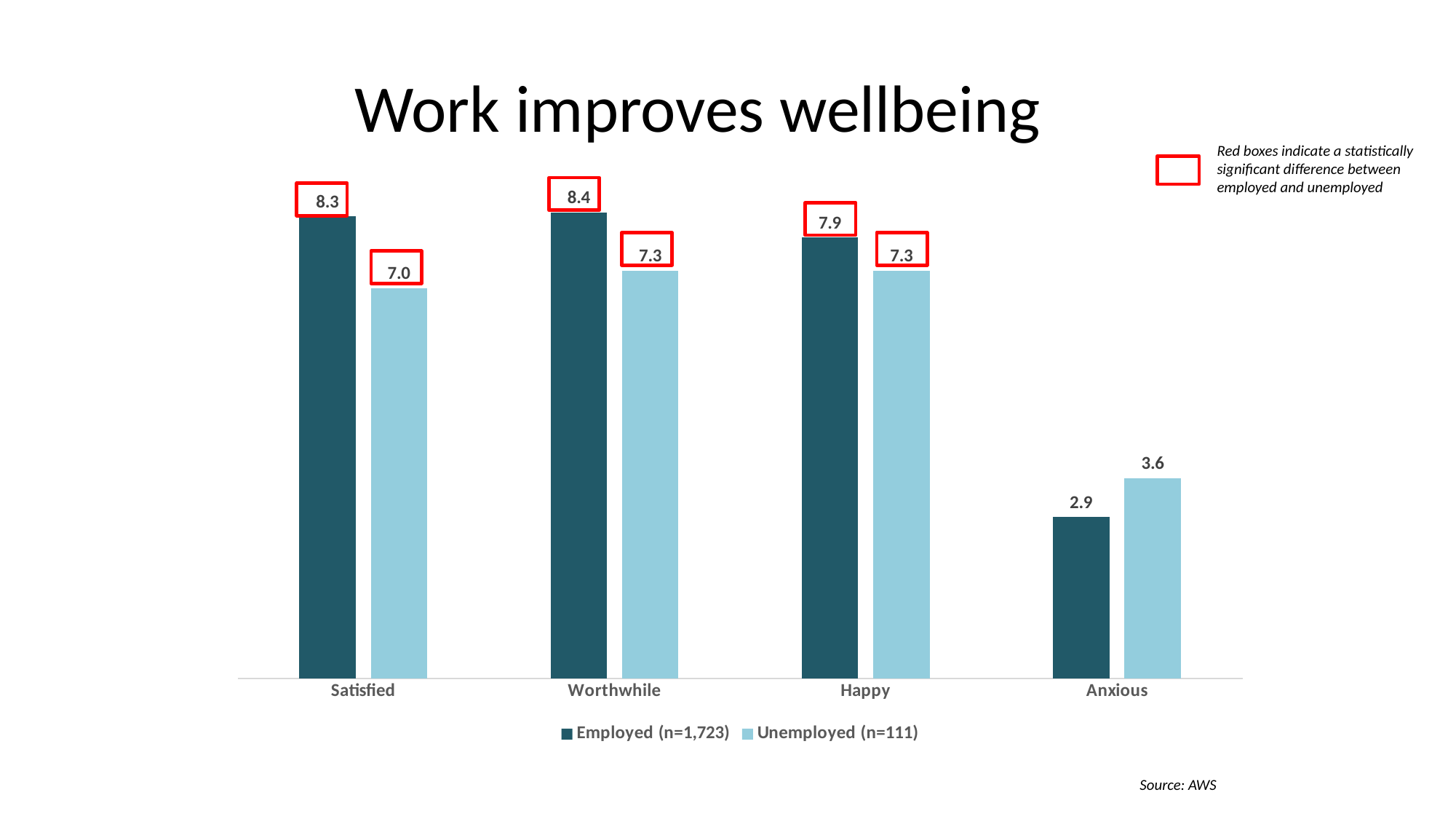
What is the Employed value for Satisfied? 8.3 What is the Unemployed value for Worthwhile? 7.3 Which is larger for Anxious, the Employed value or the Unemployed value? Unemployed Which category has the highest Employed value? Worthwhile What is the title of the slide? Work improves wellbeing What is the Unemployed value for Happy? 7.3 What is the difference between the Employed and Unemployed values for Satisfied? 1.3 Which category has the lowest Unemployed value? Anxious How many series does the legend list? 2 What is the Employed value for Anxious? 2.9 What kind of chart is shown on the slide? Bar chart How many categories are shown on the x axis? 4